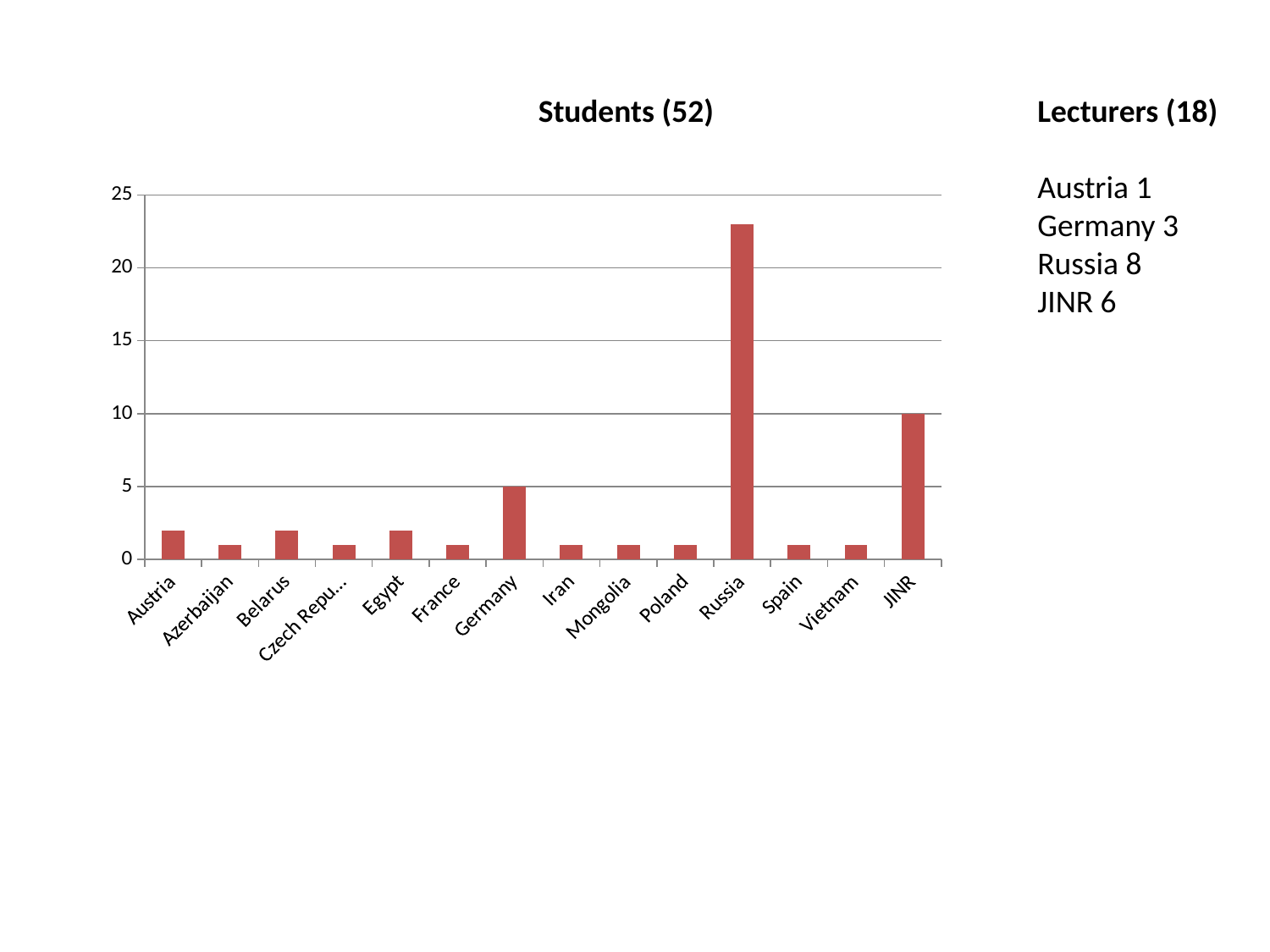
What kind of chart is shown on the slide? bar chart Is the value for Russia greater or less than 20? greater Which category has the highest value in the chart? Russia What is the title of the chart? Students (52) Is the value for Austria greater or less than 5? less Which is larger, the value for Russia or the value for JINR? Russia Is the value for Belarus greater or less than 5? less Which is larger, the value for Germany or the value for Austria? Germany What is the value for JINR in the chart? 10 What is the value for Germany in the chart? 5 What is the difference between the values for JINR and Germany? 5 How many categories are shown on the x axis of the chart? 14